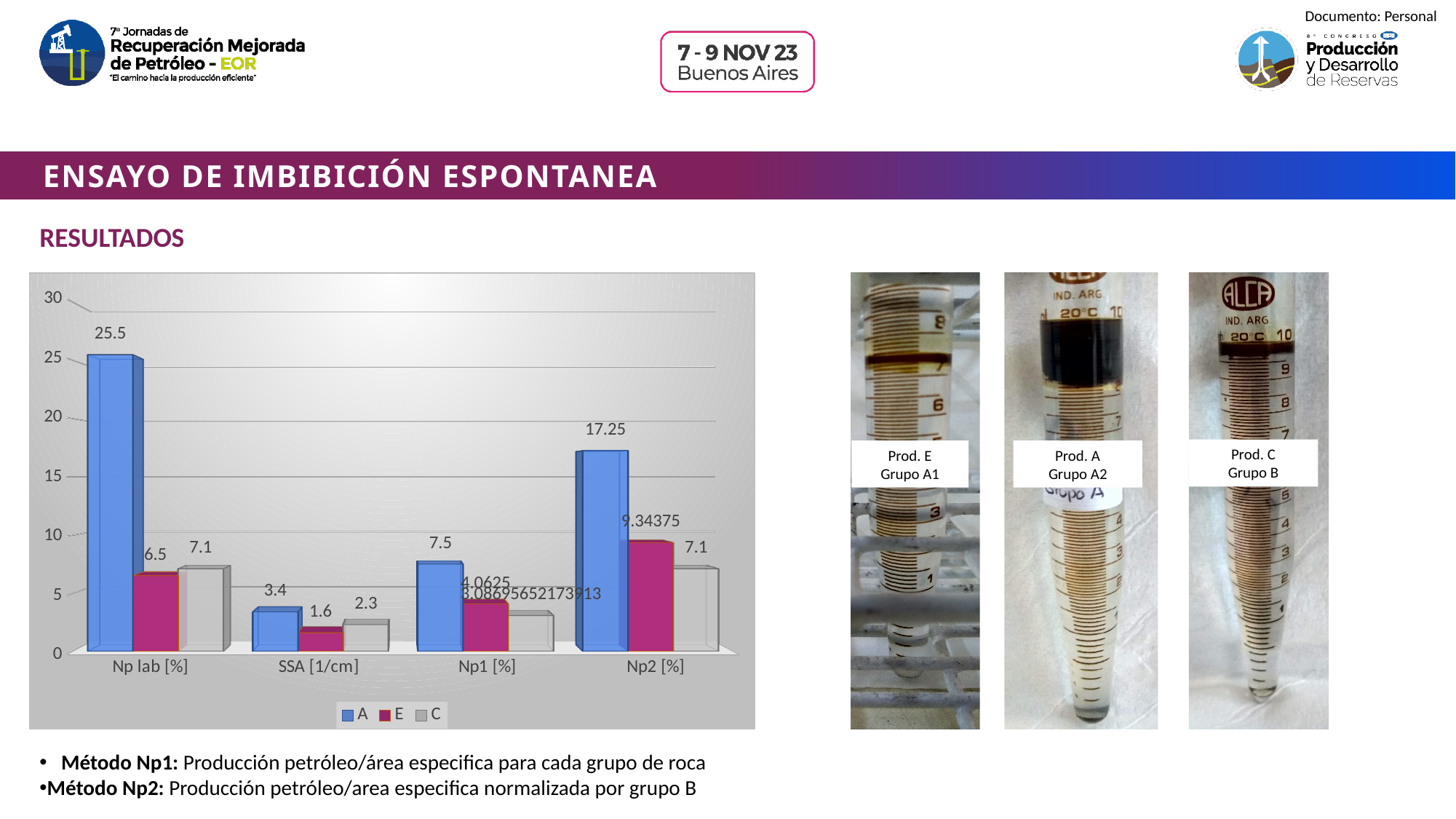
Which category has the highest value for series A? Np lab [%] What is the difference between the series A values for Np lab [%] and Np2 [%]? 8.25 Which category has the lowest value for series E? SSA [1/cm] In the Np lab [%] category, which is larger, series E or series C? C What is the value for series E in the Np2 [%] category? 9.34375 What is the value for series C in the SSA [1/cm] category? 2.3 What is the value for series A in the Np1 [%] category? 7.5 Is the value for series A in Np2 [%] greater or less than 15? greater What kind of chart is shown on the slide? bar chart How many categories are shown on the x axis? 4 How many series does the legend list? 3 What is the value for series A in the Np lab [%] category? 25.5